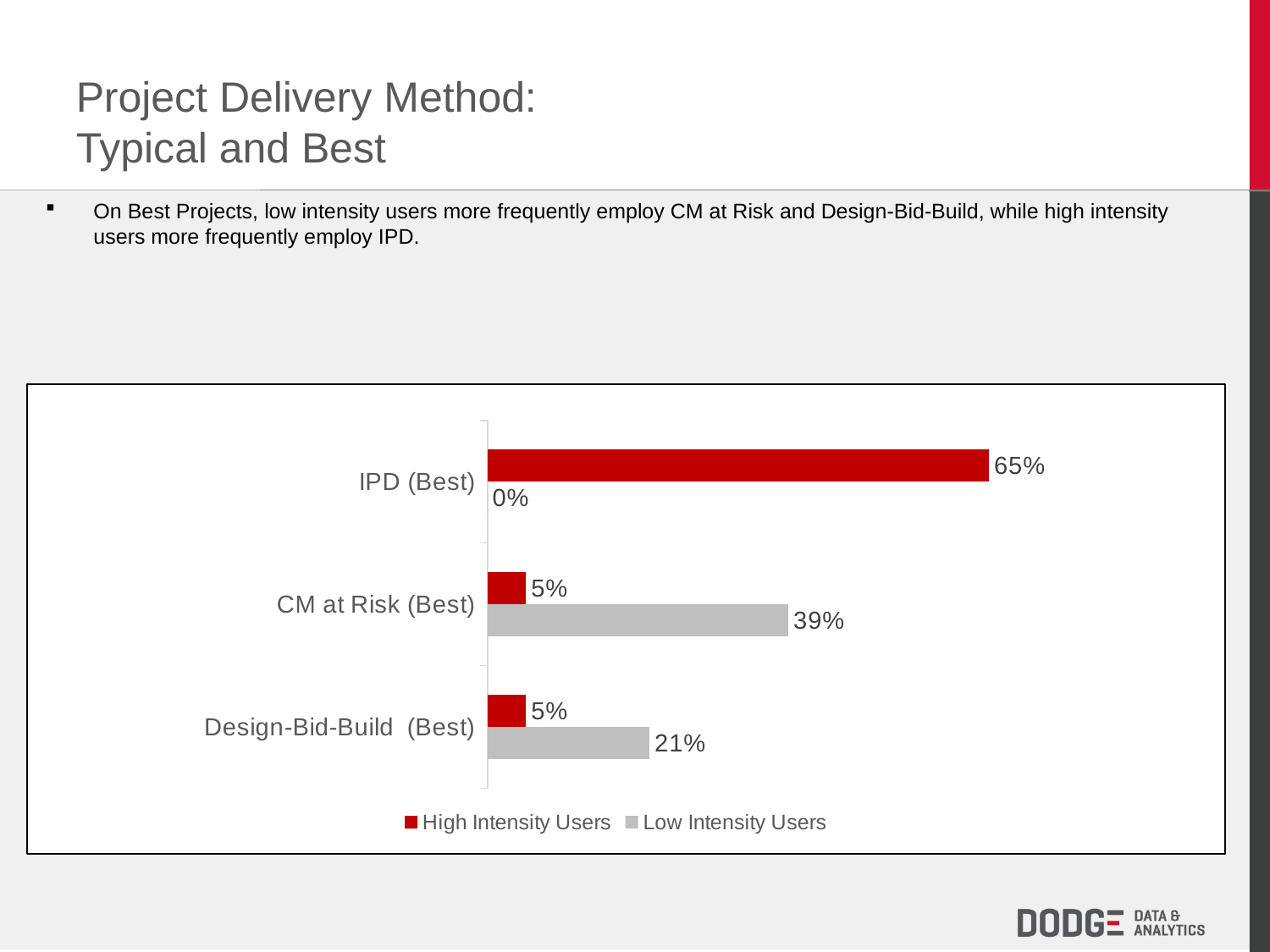
What is the value for High Intensity Users for CM at Risk (Best)? 5% Which category has the highest value for High Intensity Users? IPD (Best) Which category has the lowest value for Low Intensity Users? IPD (Best) What kind of chart is shown on the slide? Bar chart How many categories are shown in the chart? 3 For Design-Bid-Build (Best), which series has the larger value, High Intensity Users or Low Intensity Users? Low Intensity Users What is the value for Low Intensity Users for CM at Risk (Best)? 39% What is the value for High Intensity Users for IPD (Best)? 65% What is the difference between the Low Intensity Users and High Intensity Users values for CM at Risk (Best)? 34% What is the value for Low Intensity Users for IPD (Best)? 0% What is the value for Low Intensity Users for Design-Bid-Build (Best)? 21% How many series does the legend list? 2